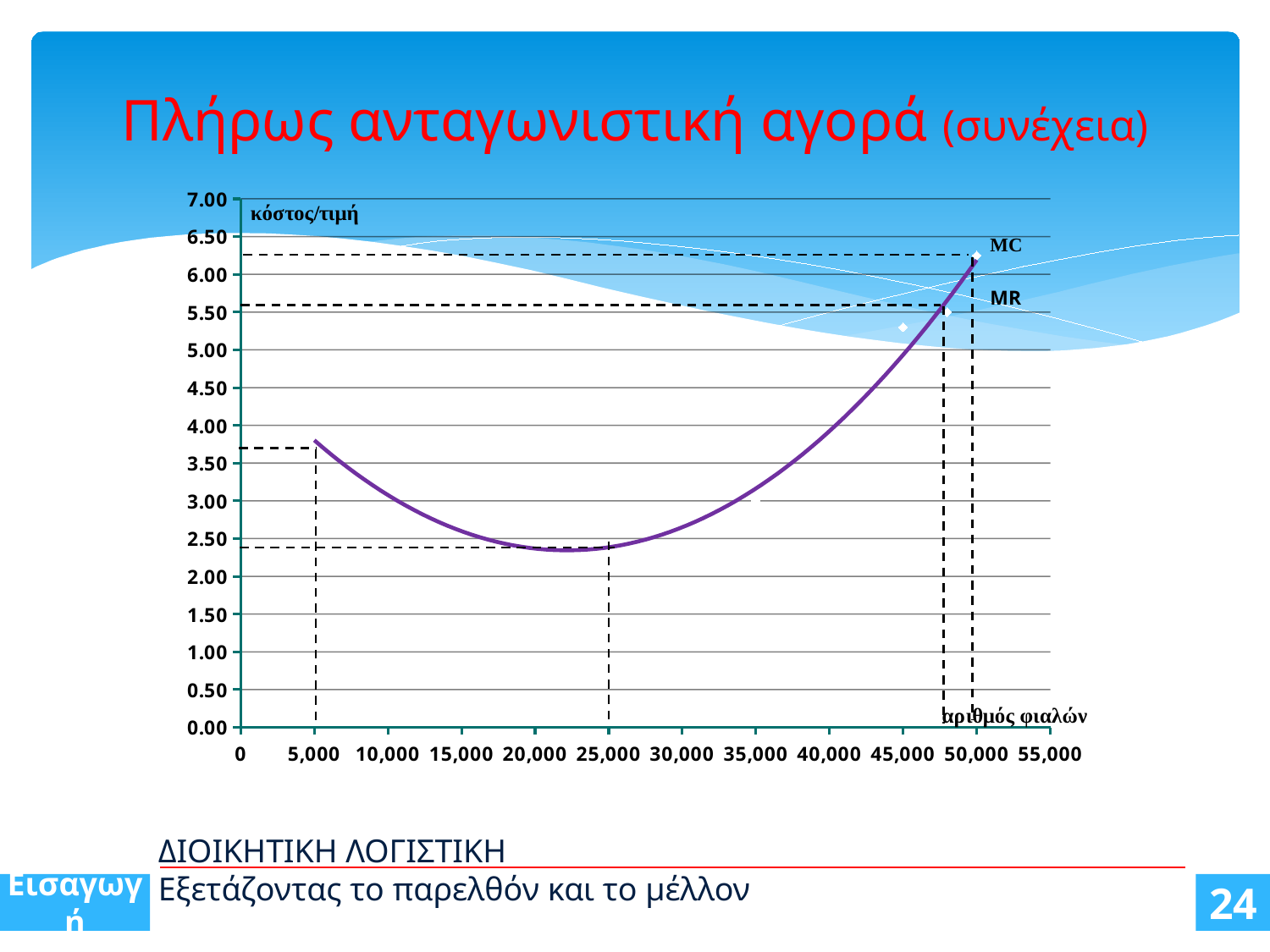
Is the value of the MC curve at 35,000 bottles greater or less than 3.50? less Is the value of the MC curve at 50,000 bottles greater or less than 6.00? greater Does the MC curve rise or fall between 5,000 and 25,000 bottles? fall Is the value of the MC curve at 25,000 bottles greater or less than 3.00? less Which is larger, the MC curve value at 50,000 bottles or at 5,000 bottles? 50,000 bottles Which is larger, the MC curve value at 5,000 bottles or at 25,000 bottles? 5,000 bottles Does the MC curve rise or fall between 25,000 and 50,000 bottles? rise What is the label on the vertical axis of the chart? κόστος/τιμή Which two labels are written next to the curves at the top right of the chart? MC and MR What kind of chart is shown on the slide? line chart